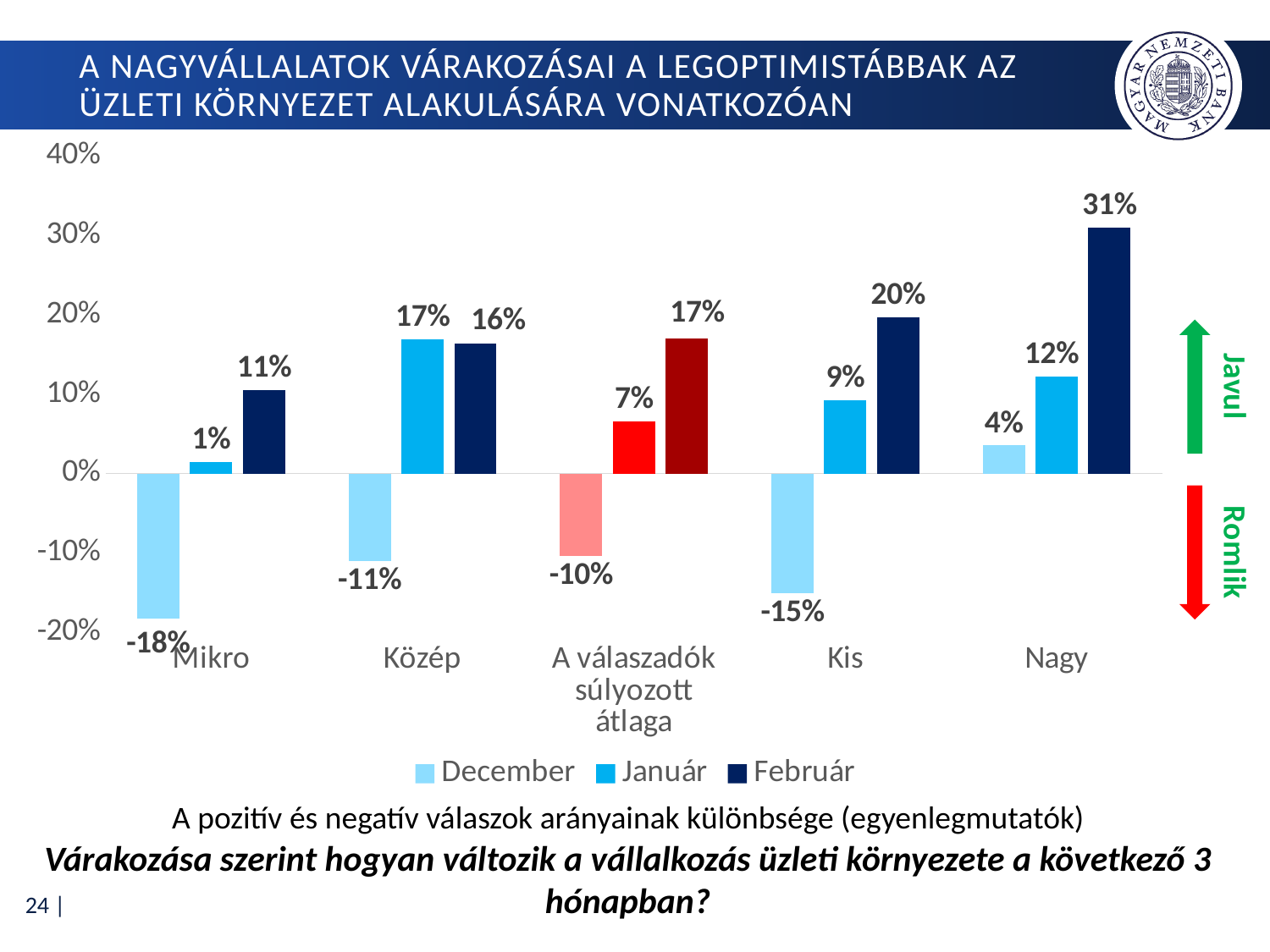
What is the December value for Mikro? -18% What is the Február value for Nagy? 31% Which series is shown in the darkest blue colour? Február What kind of chart is shown on the slide? Bar chart What is the difference between the Február and Január values for Nagy? 19% What is the Január value for Közép? 17% Which is larger for Kis: the Január value or the Február value? Február Which category has the highest Február value? Nagy Which category has the lowest December value? Mikro How many categories are shown on the x axis? 5 How many series does the legend list? 3 What is the Február value for 'A válaszadók súlyozott átlaga'? 17%